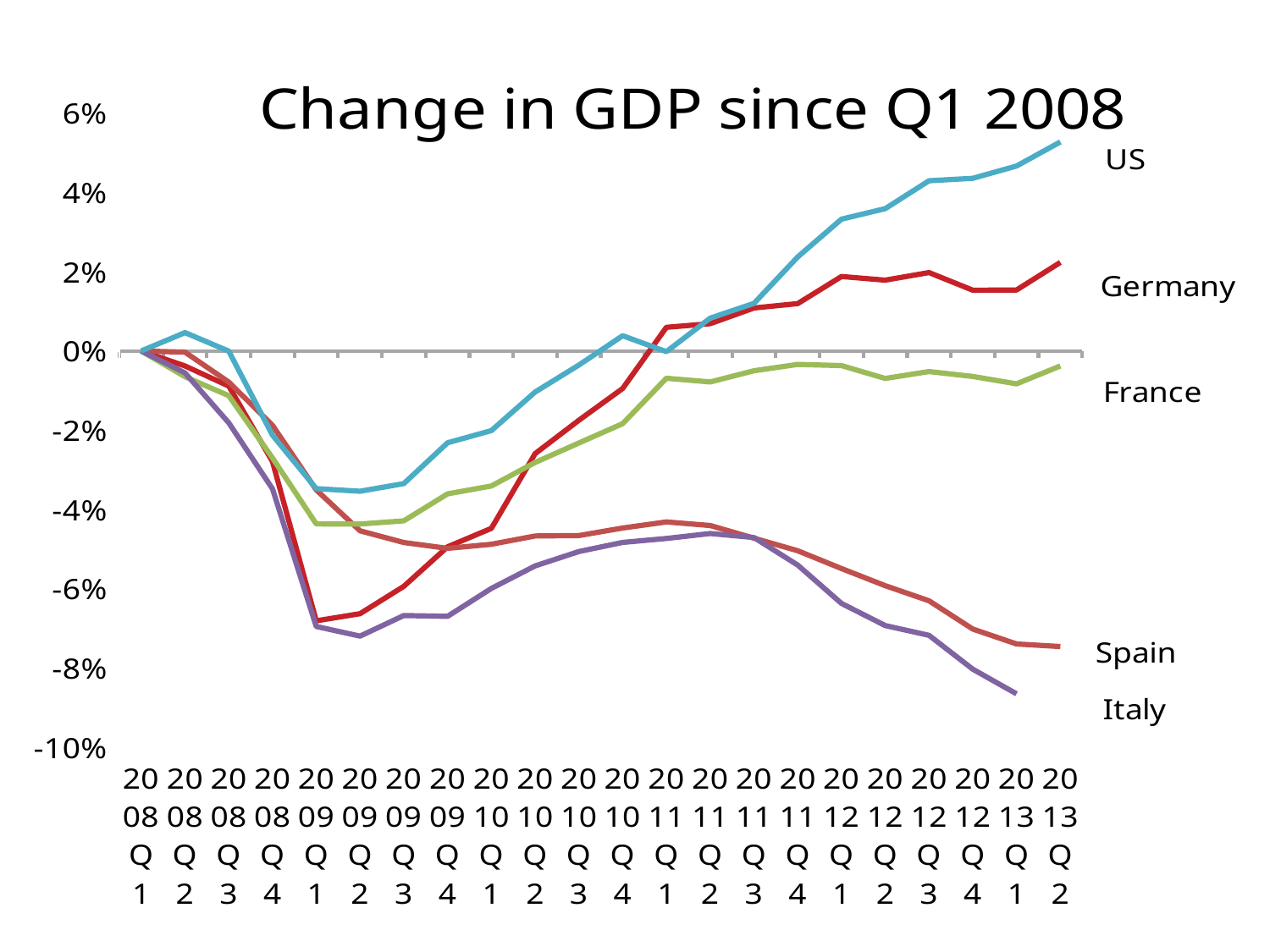
Is the value for the US at 2013 Q2 greater or less than 4%? greater Is the value for Spain at 2013 Q2 greater or less than -6%? less What is the title of the chart? Change in GDP since Q1 2008 At 2013 Q2, which is larger: the value for the US or the value for Germany? US Is the value for France at 2013 Q2 greater or less than 0%? less Which country has the lowest change in GDP at 2013 Q1? Italy How many countries (series) are plotted on the chart? 5 What kind of chart is shown on the slide? line chart Which country has the highest change in GDP at 2013 Q2? US How many quarters are shown along the x axis? 22 Does the US line generally rise or fall from 2009 Q2 to 2013 Q2? rise